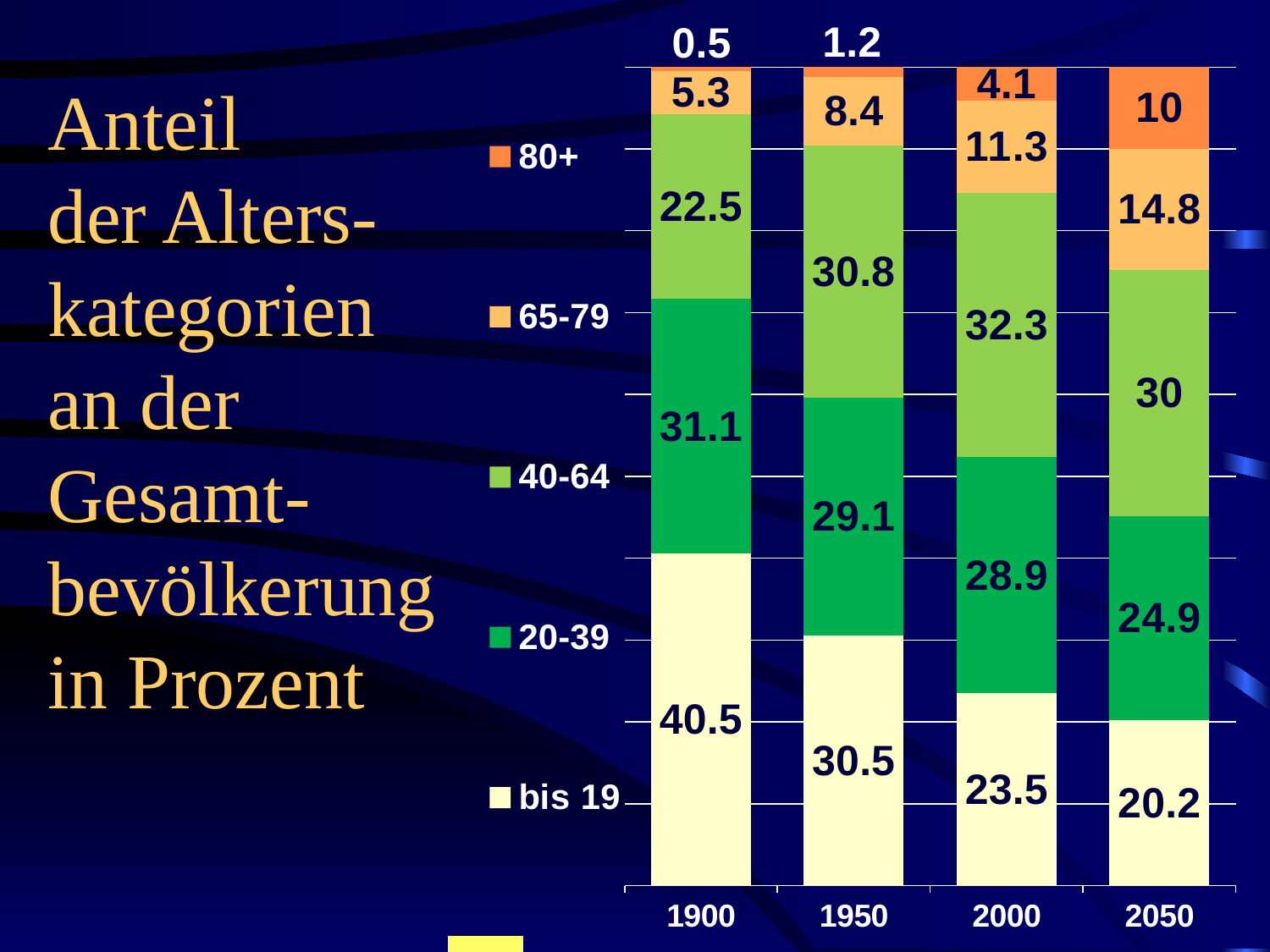
What is the value for the '80+' category in 2050? 10 What is the value for the 'bis 19' category in 1900? 40.5 Which is larger, the '20-39' value in 1900 or in 2050? 1900 What is the value for the '65-79' category in 1950? 8.4 How many series does the legend list? 5 What kind of chart is shown on the slide? stacked bar chart In which year is the '80+' share lowest? 1900 In which year is the 'bis 19' share highest? 1900 What is the difference between the 'bis 19' values for 1900 and 2050? 20.3 How many years are shown along the x axis? 4 Does the '65-79' share rise or fall from 1900 to 2050? rise What is the value for the '40-64' category in 2000? 32.3